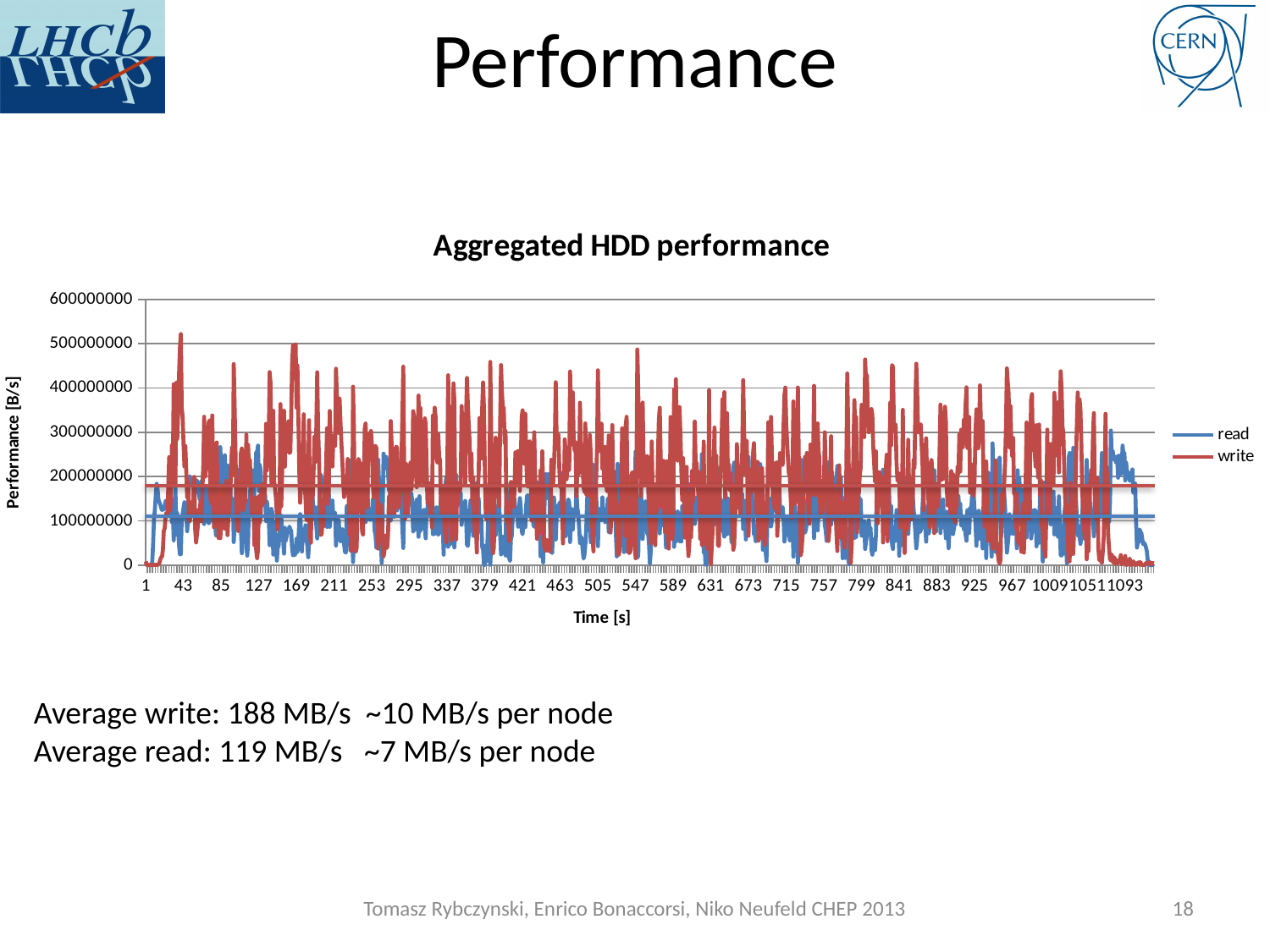
Is the horizontal average line for the write series greater or less than 100000000? greater How many series does the chart legend list? 2 Which series is drawn in red in the chart? write What is the label of the x axis of the chart? Time [s] Which series, read or write, generally reaches higher values in the chart? write Is the highest peak of the read series greater or less than 400000000? less Is the highest peak of the write series greater or less than 500000000? greater What is the title of the chart? Aggregated HDD performance What is the label of the y axis of the chart? Performance [B/s] What is the highest tick value shown on the y axis? 600000000 What kind of chart is shown on the slide? line chart